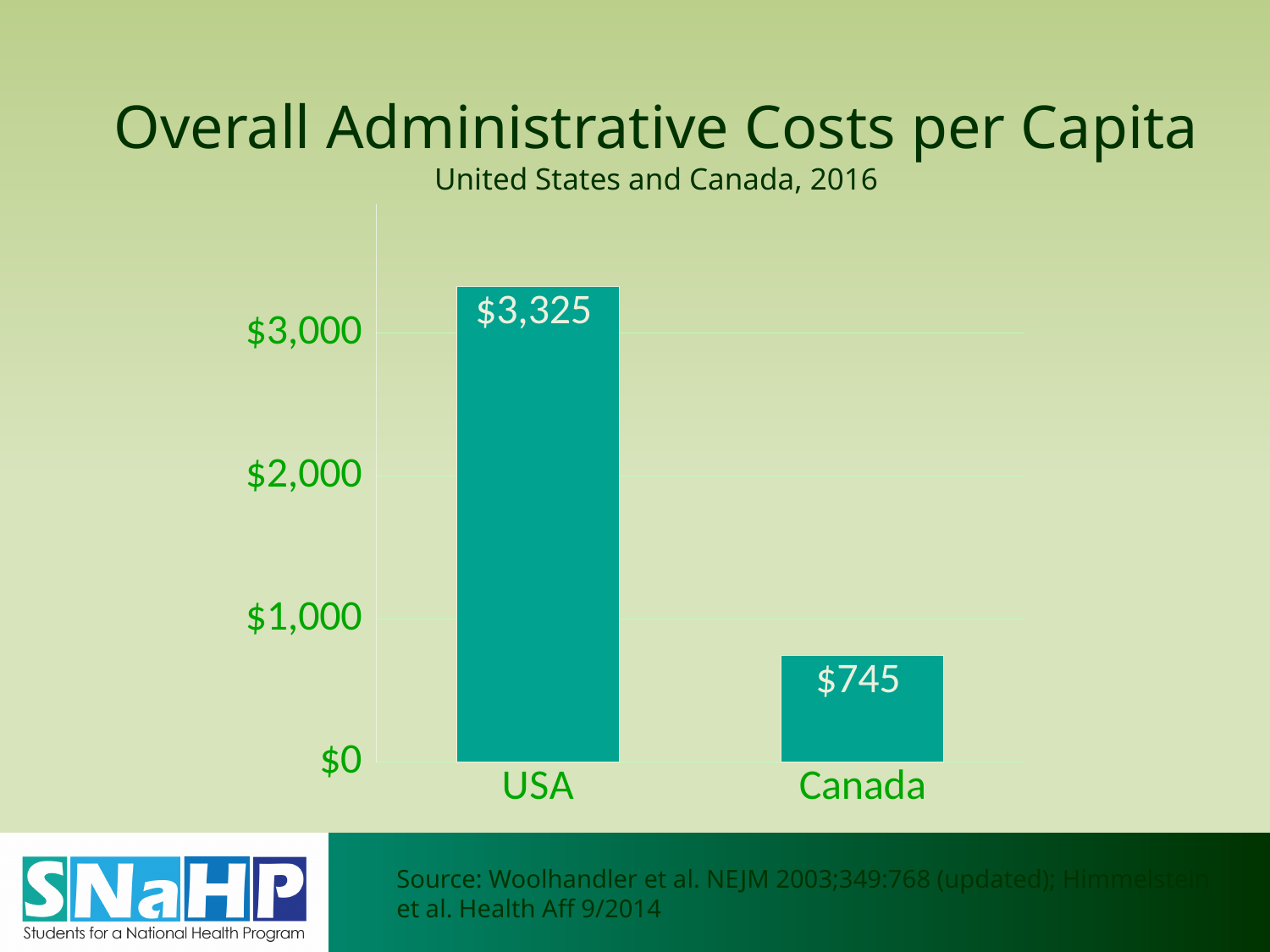
What is the overall administrative cost per capita for Canada? $745 Which country has the higher administrative cost per capita? USA Is the value for the USA larger or smaller than the value for Canada? larger How many countries are shown in the chart? 2 Is the value for the USA greater or less than $3,000? greater What is the overall administrative cost per capita for the USA? $3,325 Which country has the lower administrative cost per capita? Canada What year does the chart subtitle refer to? 2016 Is the value for Canada greater or less than $1,000? less What is the title of the chart? Overall Administrative Costs per Capita What is the difference between the USA and Canada administrative costs per capita? $2,580 What kind of chart is shown on the slide? bar chart